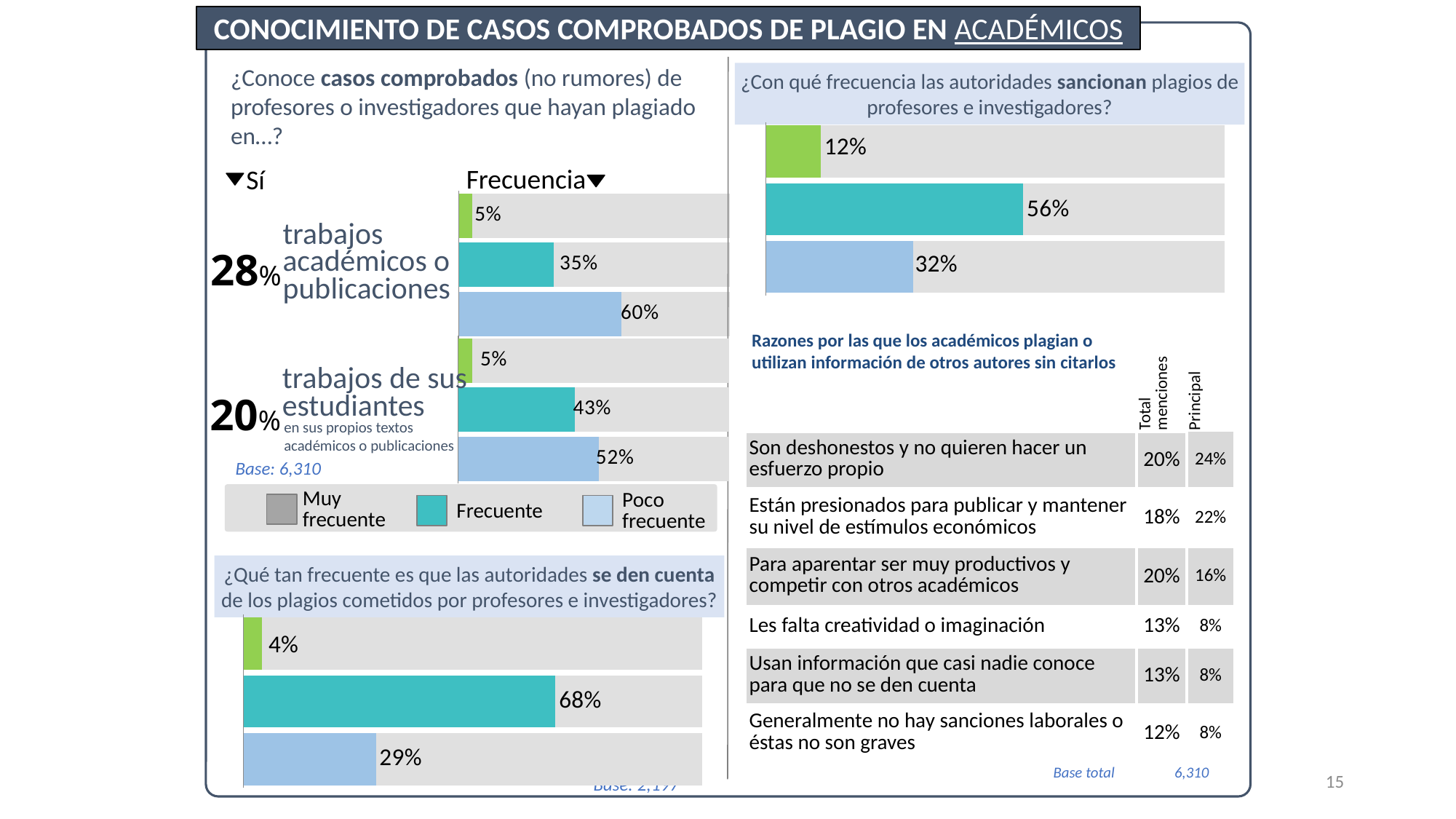
In the chart '¿Con qué frecuencia las autoridades sancionan plagios de profesores e investigadores?', what is the value for 'Poco frecuente'? 32% In the chart '¿Qué tan frecuente es que las autoridades se den cuenta de los plagios cometidos por profesores e investigadores?', what is the value for 'Frecuente'? 68% In the chart '¿Con qué frecuencia las autoridades sancionan plagios de profesores e investigadores?', which category has the highest value? Frecuente In the top-left chart '¿Conoce casos comprobados (no rumores) de profesores o investigadores que hayan plagiado en…?', what percentage answered 'Sí' for 'trabajos académicos o publicaciones'? 28% In the chart '¿Qué tan frecuente es que las autoridades se den cuenta de los plagios cometidos por profesores e investigadores?', which category has the lowest value? Muy frecuente In the chart '¿Qué tan frecuente es que las autoridades se den cuenta de los plagios cometidos por profesores e investigadores?', what is the difference between 'Frecuente' and 'Poco frecuente'? 39% In the top-left chart '¿Conoce casos comprobados (no rumores) de profesores o investigadores que hayan plagiado en…?', what is the difference between the 'Poco frecuente' values for 'trabajos académicos o publicaciones' and 'trabajos de sus estudiantes'? 8% In the top-left chart '¿Conoce casos comprobados (no rumores) de profesores o investigadores que hayan plagiado en…?', which is larger: the 'Frecuente' value for 'trabajos académicos o publicaciones' or for 'trabajos de sus estudiantes'? trabajos de sus estudiantes In the chart '¿Con qué frecuencia las autoridades sancionan plagios de profesores e investigadores?', what is the value for 'Frecuente'? 56% What kind of chart is '¿Con qué frecuencia las autoridades sancionan plagios de profesores e investigadores?'? bar chart How many series does the legend of the top-left chart list? 3 In the top-left chart '¿Conoce casos comprobados (no rumores) de profesores o investigadores que hayan plagiado en…?', what is the 'Poco frecuente' value for 'trabajos de sus estudiantes'? 52%